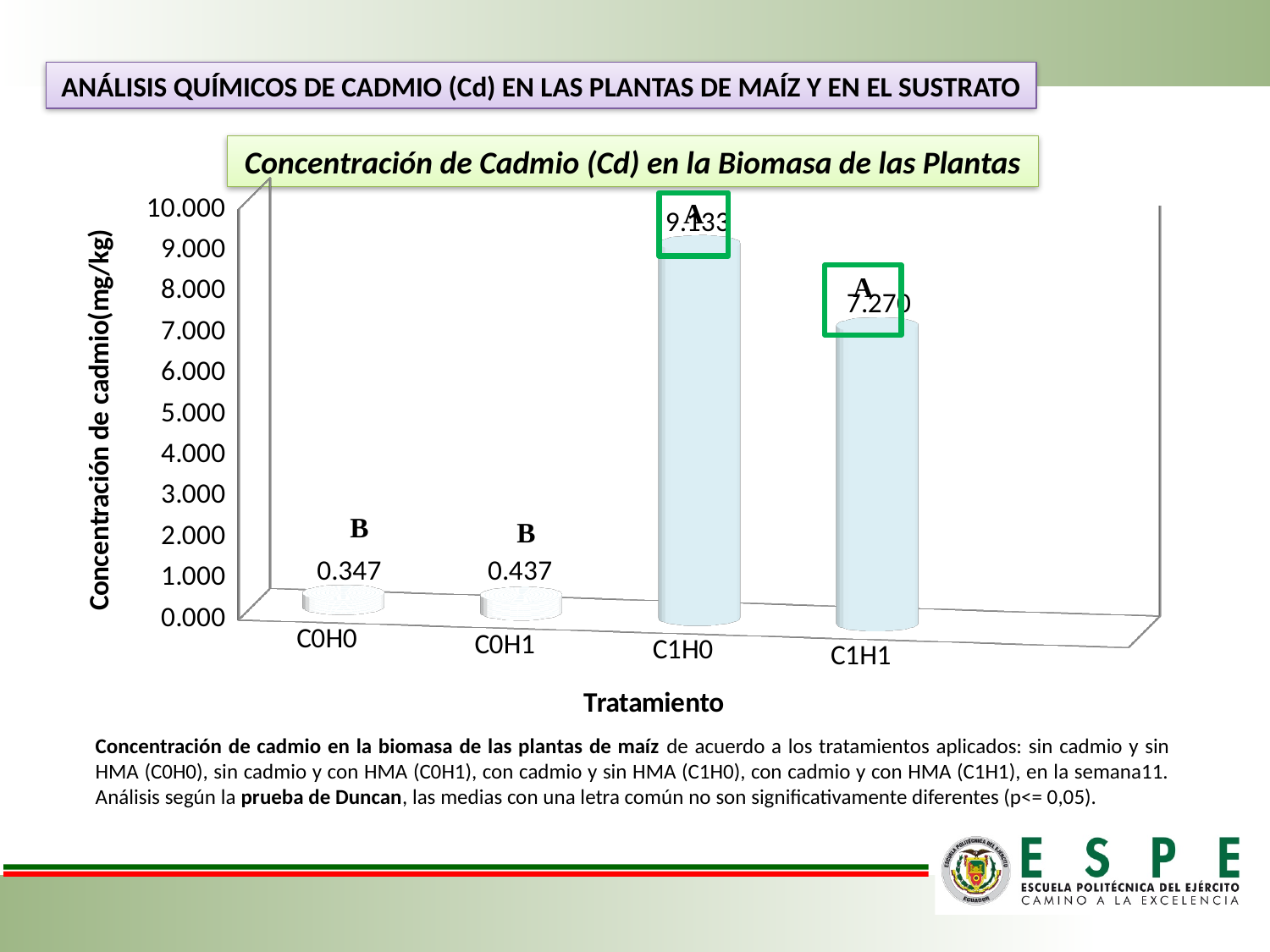
What is the cadmium concentration value shown for treatment C1H1? 7.270 Which treatment has the highest cadmium concentration in plant biomass? C1H0 What is the cadmium concentration value shown for treatment C0H1? 0.437 What is the title of the chart? Concentración de Cadmio (Cd) en la Biomasa de las Plantas How many treatments are shown on the x axis of the chart? 4 What kind of chart is used to show the cadmium concentration in plant biomass? Bar chart What is the label of the y axis of the chart? Concentración de cadmio(mg/kg) Which treatment has a larger cadmium concentration, C1H0 or C1H1? C1H0 What is the cadmium concentration value shown for treatment C0H0? 0.347 What is the difference between the values for C0H1 and C0H0? 0.090 Is the value for C1H1 greater or less than 5.000? greater Which treatment has the lowest cadmium concentration in plant biomass? C0H0